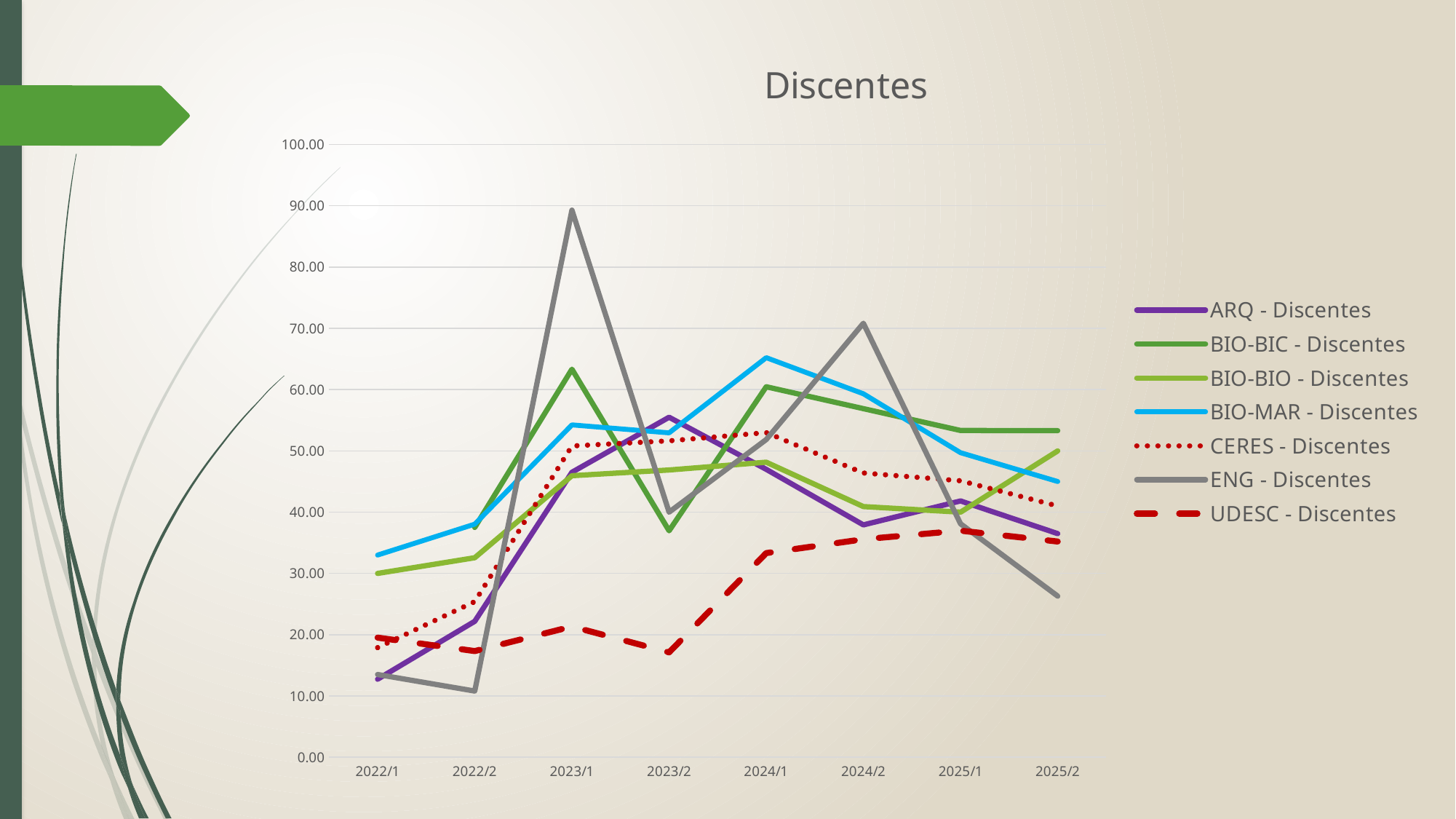
What is the title of the chart? Discentes Which series has the lowest value at 2024/1? UDESC - Discentes Is the value for ENG - Discentes at 2023/1 greater or less than 80? greater Which series has the highest value at 2023/1? ENG - Discentes Is the value for UDESC - Discentes at 2023/2 greater or less than 20? less How many series does the legend list? 7 What kind of chart is shown on the slide? Line chart How many periods are shown on the x axis? 8 Does the ENG - Discentes line rise or fall from 2024/2 to 2025/2? Fall Which series has the lowest value at 2022/2? ENG - Discentes At 2023/2, which is larger: ARQ - Discentes or ENG - Discentes? ARQ - Discentes Is the value for BIO-MAR - Discentes at 2024/1 greater or less than 60? greater